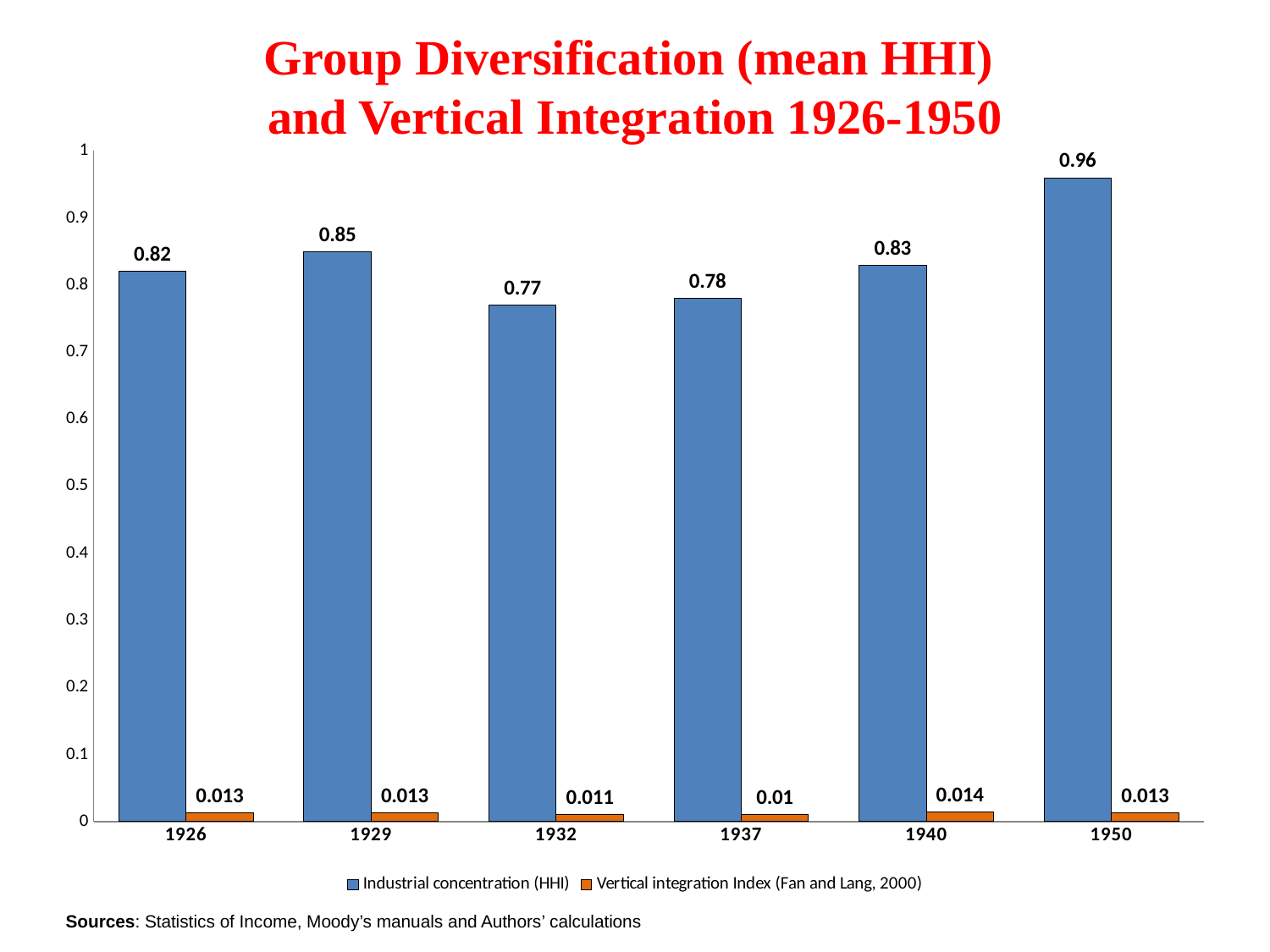
Which year has the larger Industrial concentration (HHI) value, 1929 or 1940? 1929 How many years are shown on the x axis? 6 Is the Industrial concentration (HHI) value for 1937 greater or less than 0.8? less What kind of chart is shown on the slide? bar chart What is the Vertical integration Index value for 1940? 0.014 Which year has the highest Industrial concentration (HHI) value? 1950 What colour are the Vertical integration Index bars? orange What is the Industrial concentration (HHI) value for 1932? 0.77 What is the Industrial concentration (HHI) value for 1950? 0.96 How many series does the legend list? 2 What is the difference between the Industrial concentration (HHI) values for 1950 and 1932? 0.19 Which year has the lowest Vertical integration Index value? 1937